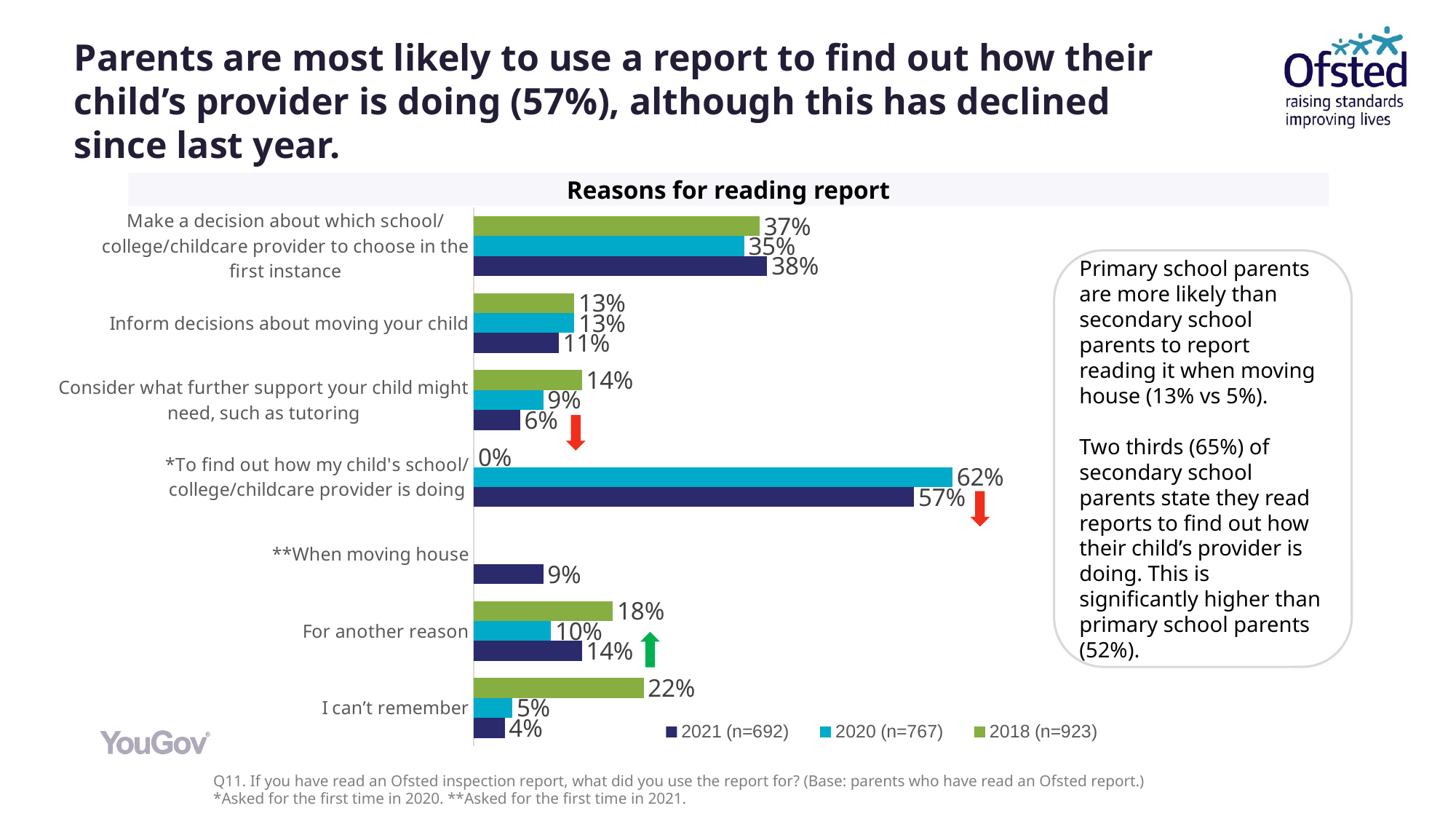
What is the difference between the 2020 and 2021 values for 'To find out how my child's school/college/childcare provider is doing'? 5% What is the 2020 value for 'To find out how my child's school/college/childcare provider is doing'? 62% How many reason categories are shown on the 'Reasons for reading report' chart? 7 What is the 2021 value for 'To find out how my child's school/college/childcare provider is doing'? 57% For 'For another reason', which is larger: the 2018 value or the 2020 value? 2018 What is the sample size (n) shown in the legend for the 2020 series? 767 What kind of chart is shown under the title 'Reasons for reading report'? Bar chart Which reason has the highest 2021 value? To find out how my child's school/college/childcare provider is doing How many series does the legend of the 'Reasons for reading report' chart list? 3 What is the 2021 value for 'When moving house'? 9% What is the 2018 value for 'I can't remember'? 22% Which reason has the lowest 2021 value? I can't remember